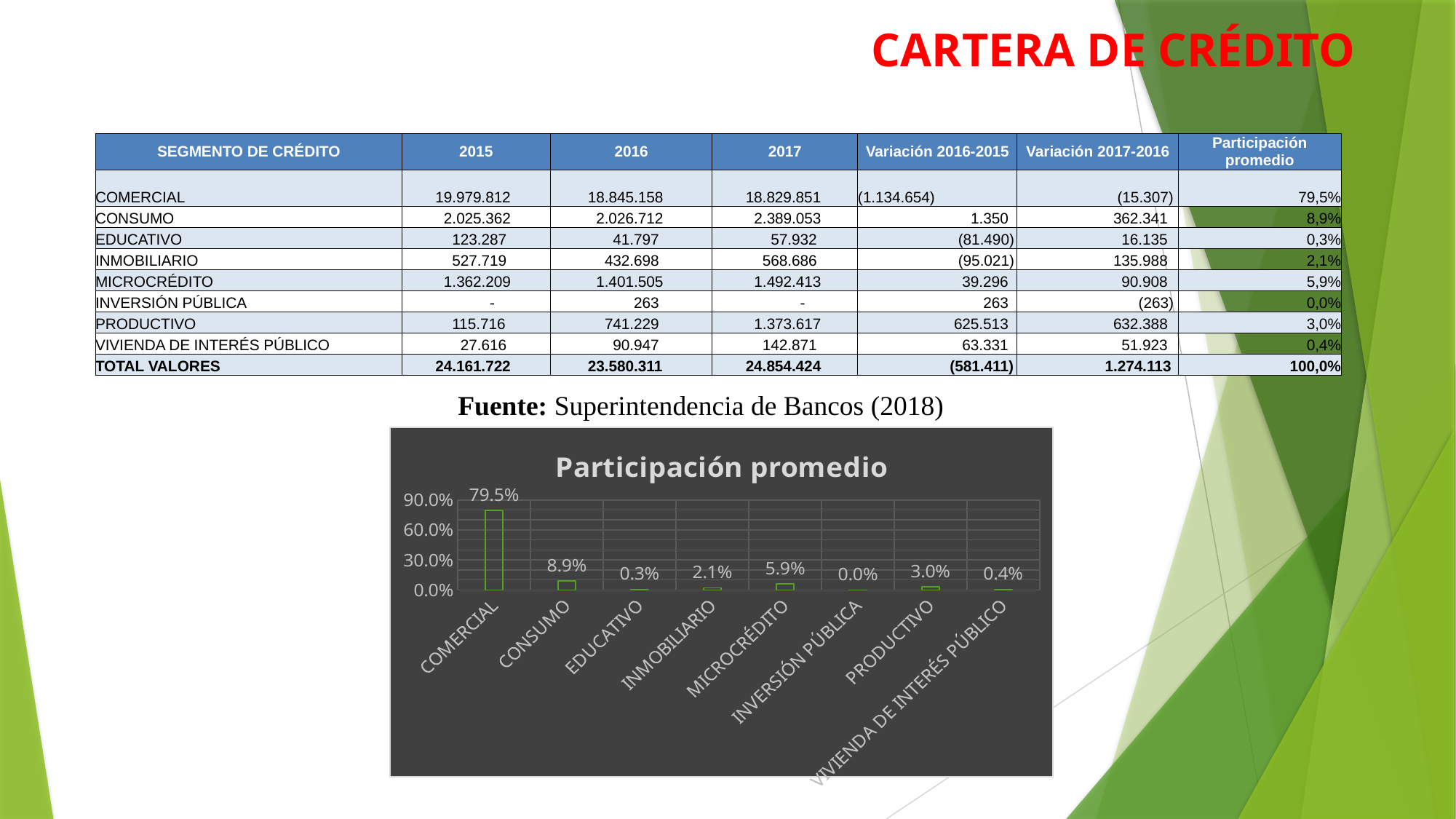
What is the value for MICROCRÉDITO in the Participación promedio chart? 5.9% What is the value for PRODUCTIVO in the Participación promedio chart? 3.0% What is the value for CONSUMO in the Participación promedio chart? 8.9% Which category has the lowest value in the Participación promedio chart? INVERSIÓN PÚBLICA What is the title of the chart on the slide? Participación promedio What is the difference between the values for COMERCIAL and CONSUMO in the Participación promedio chart? 70.6% What is the value for COMERCIAL in the Participación promedio chart? 79.5% Is the value for COMERCIAL in the Participación promedio chart greater or less than 60.0%? greater How many categories are shown in the Participación promedio chart? 8 Which is larger in the Participación promedio chart, MICROCRÉDITO or INMOBILIARIO? MICROCRÉDITO What kind of chart is the Participación promedio chart? bar chart Which category has the highest value in the Participación promedio chart? COMERCIAL